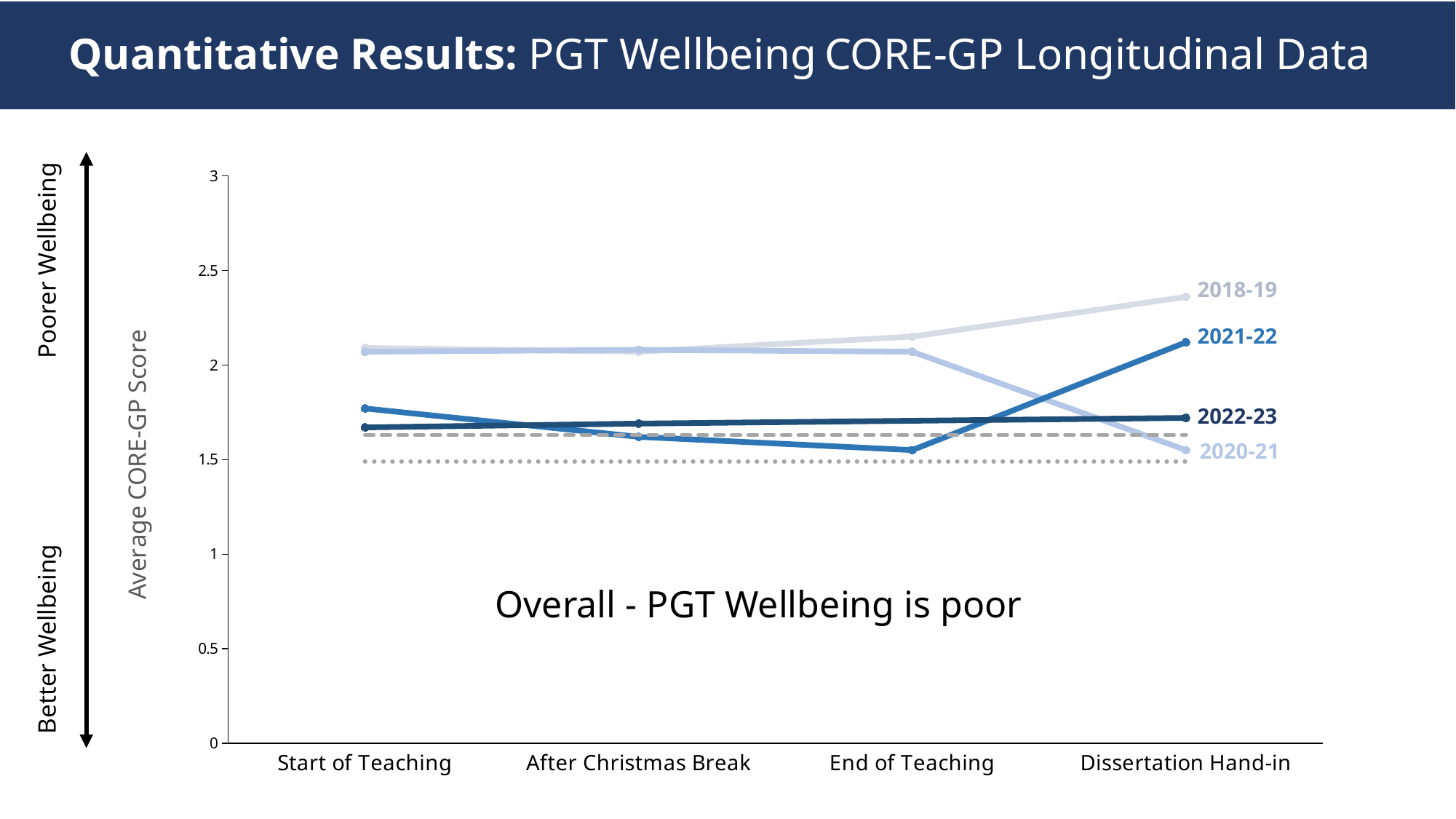
Which series has the highest value at Dissertation Hand-in? 2018-19 How many points are there along the x axis of the chart? 4 What is the title of the y axis? Average CORE-GP Score Is the value for 2021-22 at End of Teaching greater or less than 2? less What kind of chart is shown on the slide? line chart At Dissertation Hand-in, which is larger: the value for 2021-22 or the value for 2020-21? 2021-22 Which series has the lowest value at End of Teaching? 2021-22 Does the 2018-19 line rise or fall from Start of Teaching to Dissertation Hand-in? rise How many year series are labelled on the chart? 4 Is the value for 2018-19 at Dissertation Hand-in greater or less than 2? greater Which series has the lowest value at Dissertation Hand-in? 2020-21 Does the 2020-21 line rise or fall between End of Teaching and Dissertation Hand-in? fall